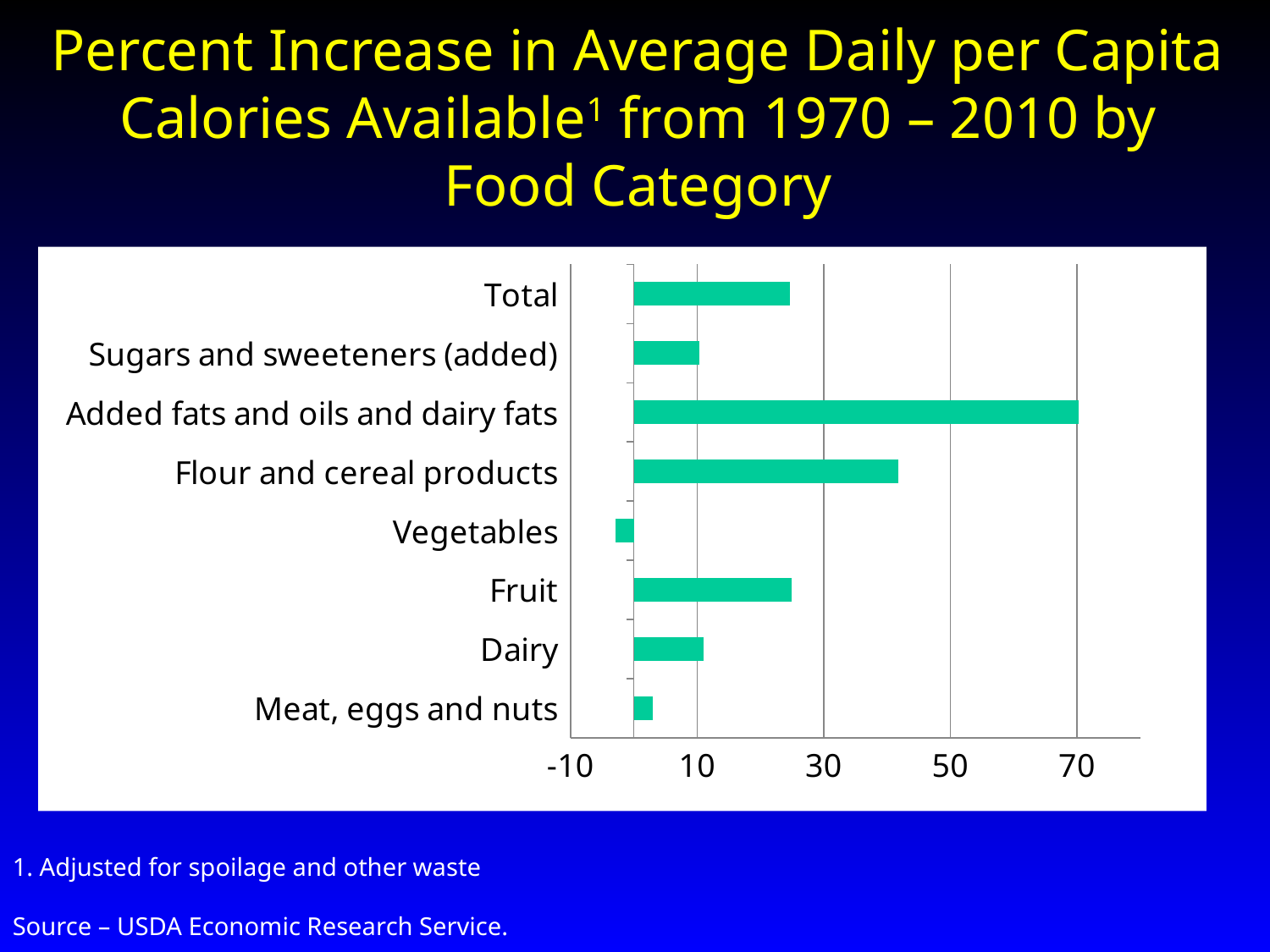
Which is larger, the value for Flour and cereal products or the value for Total? Flour and cereal products What kind of chart is shown on the slide? bar chart Is the value for Fruit greater or less than 10? greater Which category has the lowest percent increase? Vegetables Which is larger, the value for Dairy or the value for Meat, eggs and nuts? Dairy Is the value for Total greater or less than 30? less How many food categories are plotted on the chart? 8 Is the value for Flour and cereal products greater or less than 30? greater Which category has the highest percent increase? Added fats and oils and dairy fats